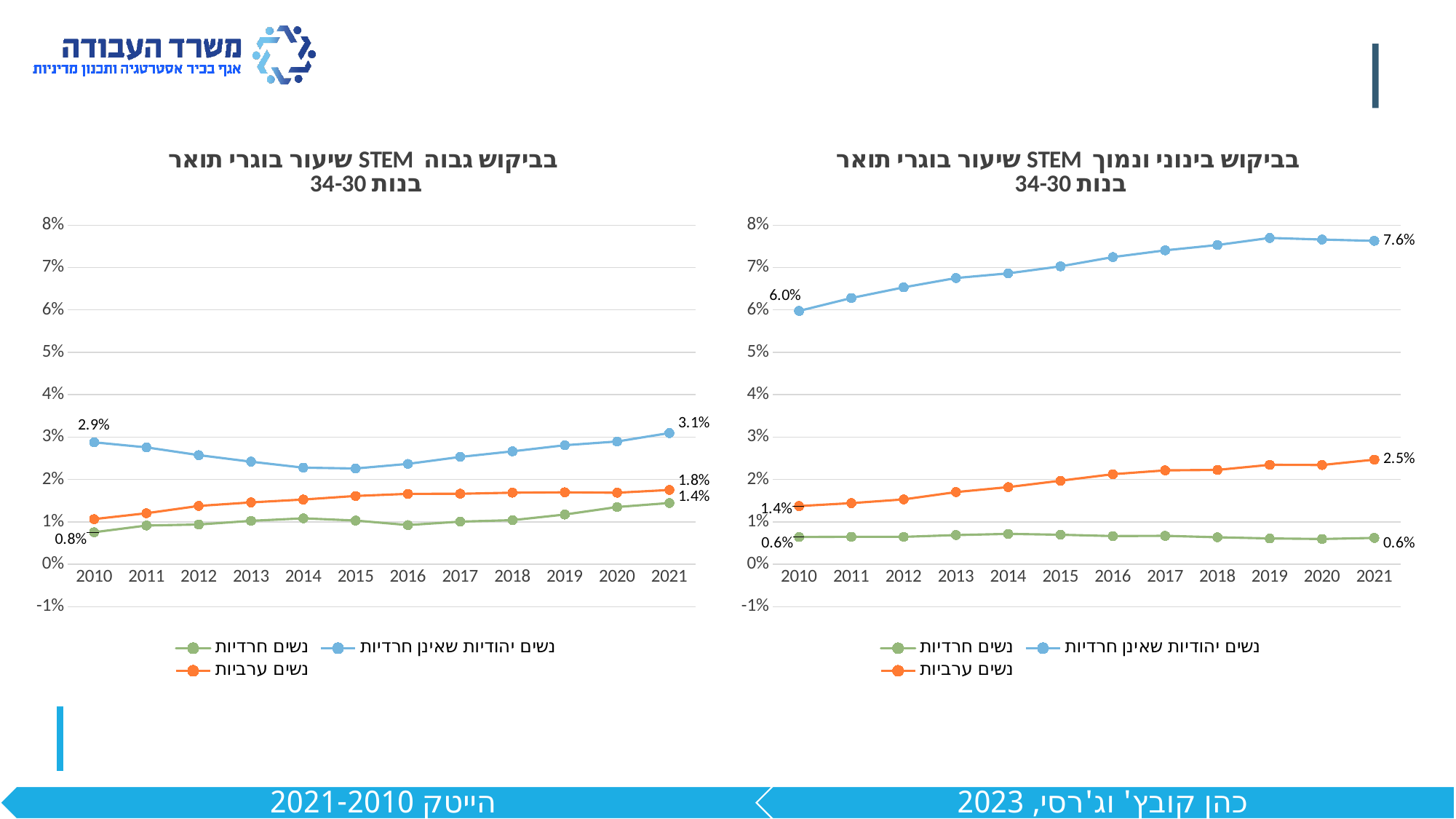
In the right chart (בביקוש בינוני ונמוך), by how much did the value for נשים יהודיות שאינן חרדיות change from 2010 to 2021? 1.6% In the right chart (בביקוש בינוני ונמוך), what is the value for נשים ערביות in 2010? 1.4% In the right chart (בביקוש בינוני ונמוך), which series has the highest value in 2021? נשים יהודיות שאינן חרדיות In the right chart (בביקוש בינוני ונמוך), does the value for נשים ערביות rise or fall from 2010 to 2021? rise In the right chart (בביקוש בינוני ונמוך), what is the value for נשים יהודיות שאינן חרדיות in 2021? 7.6% What kind of chart is the left chart (בביקוש גבוה)? line chart In the left chart (בביקוש גבוה), what is the value for נשים חרדיות in 2010? 0.8% How many series does the legend of the right chart (בביקוש בינוני ונמוך) list? 3 In the left chart (בביקוש גבוה), what is the difference between נשים ערביות and נשים חרדיות in 2021? 0.4% In the left chart (בביקוש גבוה), is the value for נשים יהודיות שאינן חרדיות in 2015 greater or less than 3%? less In the left chart (בביקוש גבוה), which series has the lowest value in 2010? נשים חרדיות In the left chart (בביקוש גבוה), what is the value for נשים יהודיות שאינן חרדיות in 2021? 3.1%